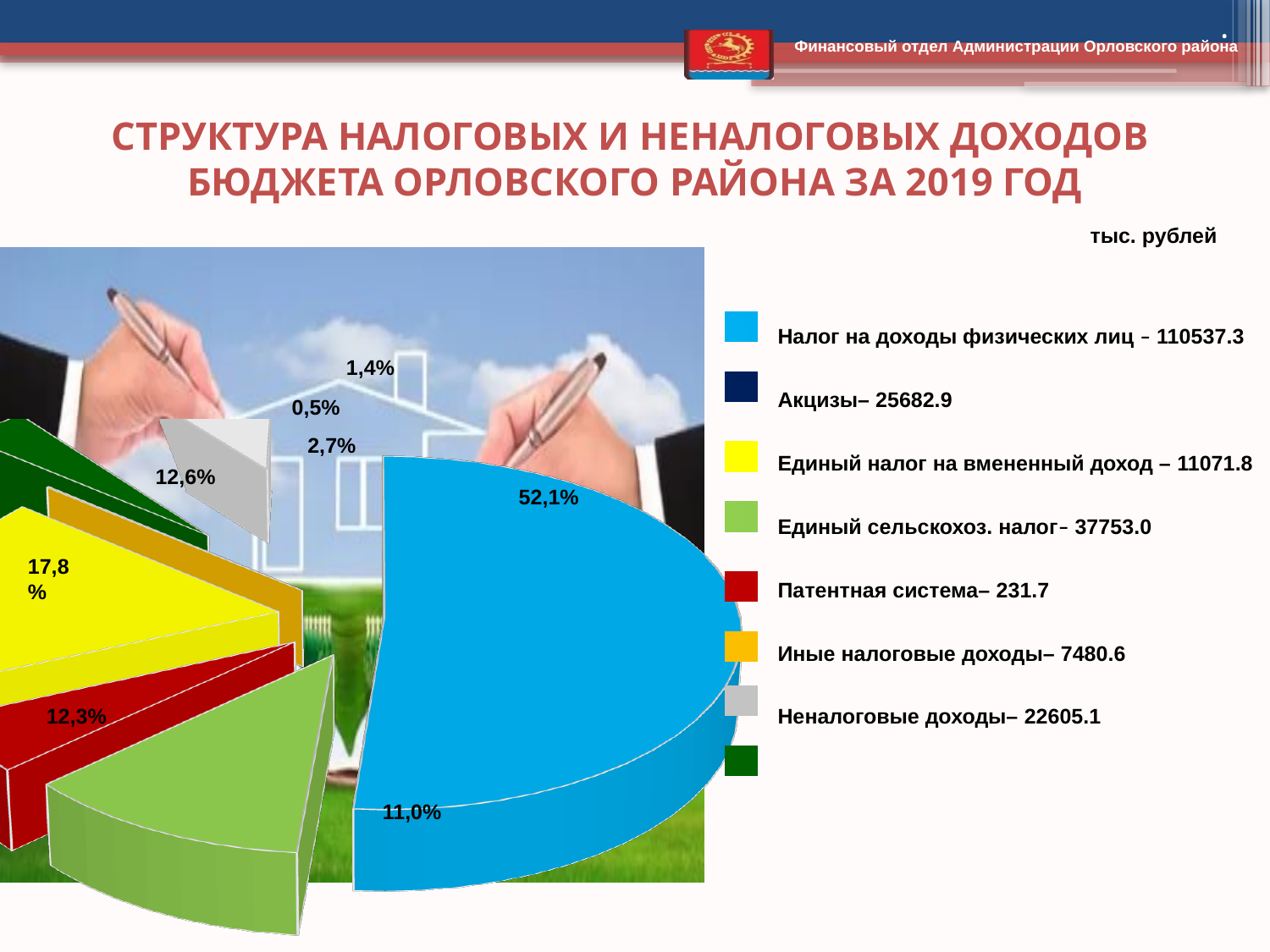
What is the largest percentage label shown on the pie chart? 52,1% How many legend entries with a name and value are listed next to the pie chart? 7 According to the legend, what is the value for Единый сельскохоз. налог? 37753.0 According to the legend, what is the value for Патентная система? 231.7 What unit is stated above the legend for the values? тыс. рублей What is the smallest percentage label shown on the pie chart? 0,5% Which has the larger value in the legend, Акцизы or Единый налог на вмененный доход? Акцизы What kind of chart is shown on the slide? pie chart According to the legend, what is the value for Акцизы? 25682.9 According to the legend, what is the value for Неналоговые доходы? 22605.1 What is the difference between the legend values for Единый сельскохоз. налог and Акцизы? 12070.1 According to the legend, what is the value for Налог на доходы физических лиц? 110537.3